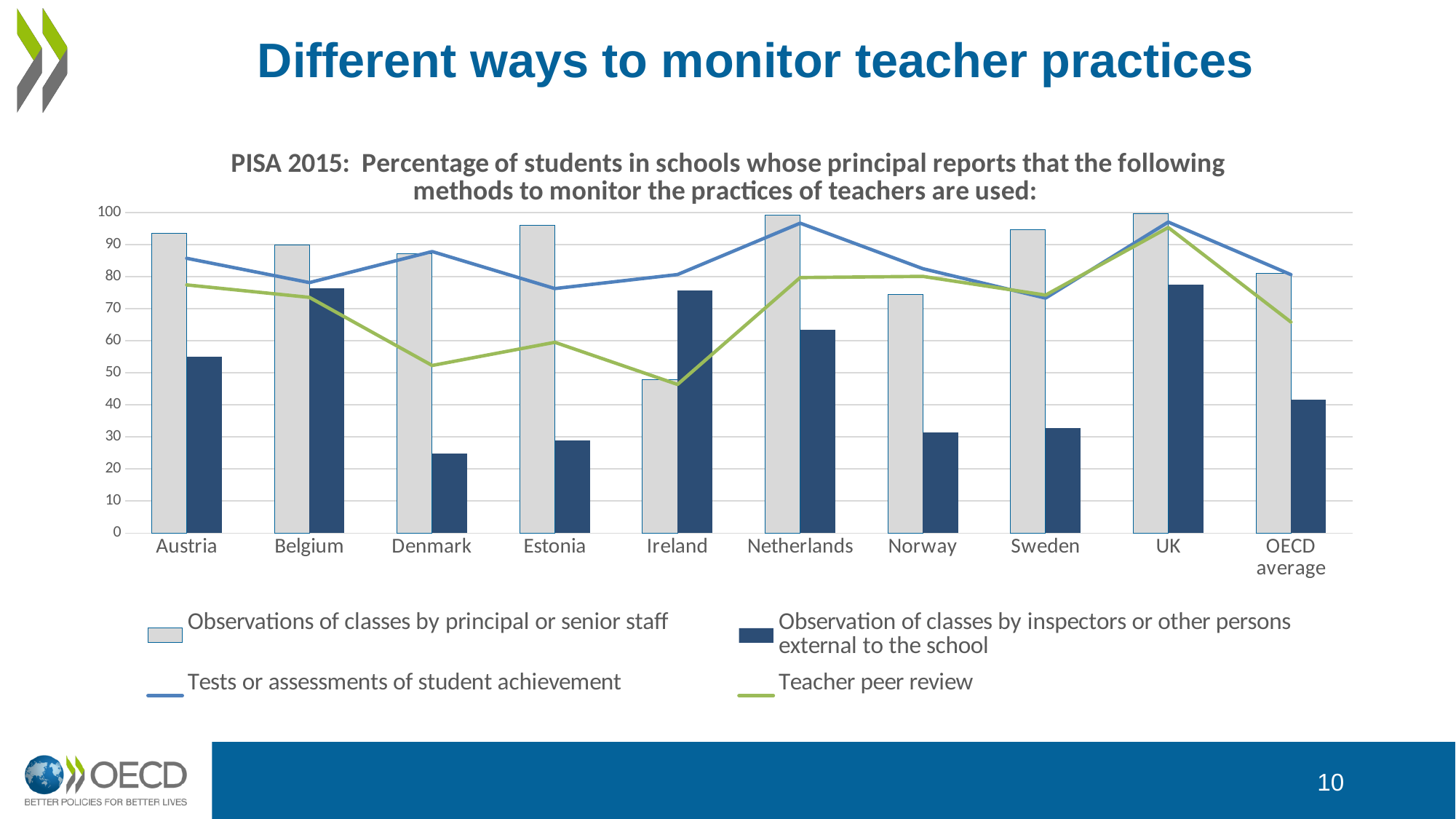
How many series does the legend list? 4 Which category has the lowest value for Observations of classes by principal or senior staff? Ireland What kind of chart is shown on the slide? A combined bar and line chart Is the value for Observations of classes by principal or senior staff in Ireland greater or less than 50? less Is the value for Observation of classes by inspectors or other persons external to the school in the Netherlands greater or less than 60? greater In Ireland, which is larger: Observations of classes by principal or senior staff, or Observation of classes by inspectors or other persons external to the school? Observation of classes by inspectors or other persons external to the school Which category has the lowest value for Teacher peer review? Ireland Which category has the highest value for Teacher peer review? UK Is the value for Observations of classes by principal or senior staff in Estonia greater or less than 90? greater Which series is drawn as a green line? Teacher peer review How many countries or categories are shown along the x axis? 10